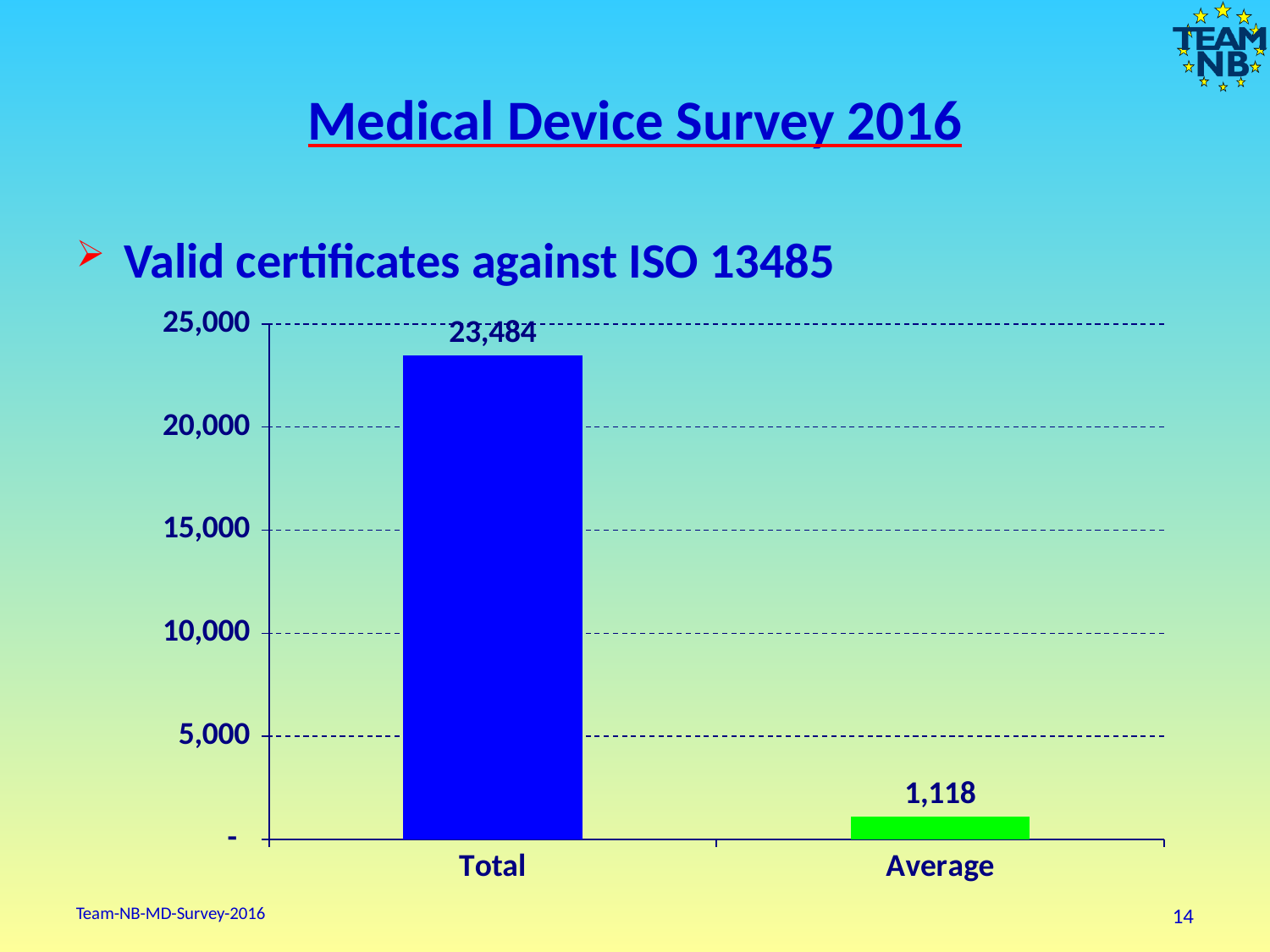
Which is larger, the value for Total or the value for Average? Total Which category has the highest value? Total How many categories are shown on the x axis? 2 What kind of chart is shown on the slide? bar chart Is the value for Total greater or less than 20,000? greater Which category has the lowest value? Average Is the value for Average greater or less than 5,000? less What colour is the bar for Average? green What is the value for Total? 23,484 What is the difference between the Total and Average values? 22,366 What is the highest value shown on the y axis? 25,000 What is the value for Average? 1,118